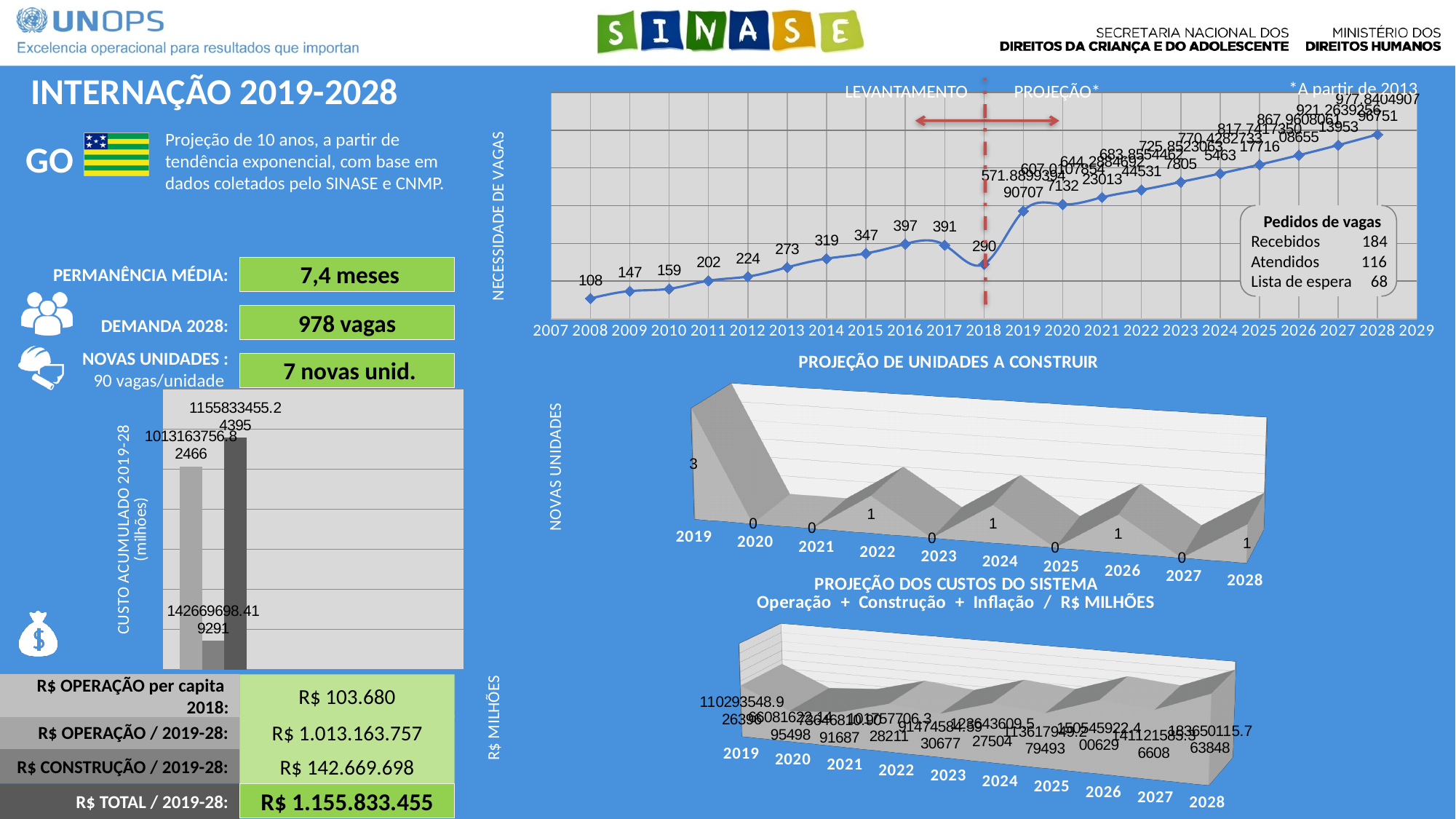
In the NECESSIDADE DE VAGAS line chart, do the values rise or fall from 2008 to 2016? rise What kind of chart is the NECESSIDADE DE VAGAS chart? line chart In the NECESSIDADE DE VAGAS line chart, what is the value for 2016? 397 In the PROJEÇÃO DE UNIDADES A CONSTRUIR chart, how many new units are shown for 2019? 3 In the NECESSIDADE DE VAGAS line chart, what is the value for 2008? 108 In the NECESSIDADE DE VAGAS line chart, what is the difference between the 2017 value and the 2018 value? 101 In the PROJEÇÃO DE UNIDADES A CONSTRUIR chart, which year has the highest number of new units? 2019 In the NECESSIDADE DE VAGAS line chart, which year has the lowest value? 2008 How many bars are in the CUSTO ACUMULADO 2019-28 chart on the left of the slide? 3 In the NECESSIDADE DE VAGAS line chart, which is larger, the value for 2016 or the value for 2017? 2016 In the NECESSIDADE DE VAGAS line chart, what is the value for 2018? 290 How many years are shown on the x axis of the PROJEÇÃO DE UNIDADES A CONSTRUIR chart? 10